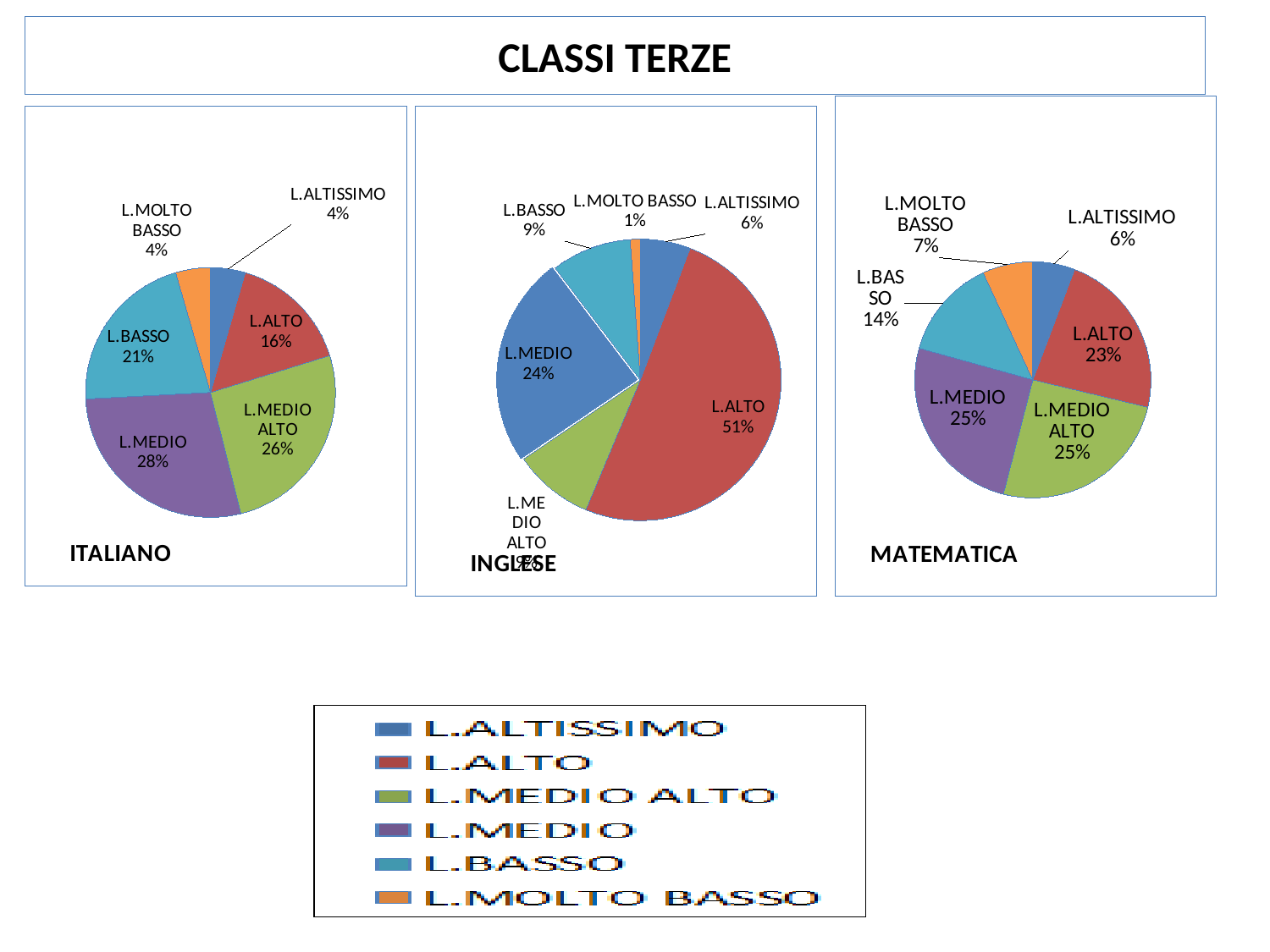
In the MATEMATICA pie chart, what percentage is L.MOLTO BASSO? 7% How many entries does the legend list? 6 In the INGLESE pie chart, which level has the largest share? L.ALTO In the ITALIANO pie chart, what is the difference between L.MEDIO ALTO and L.ALTO? 10% In the ITALIANO pie chart, which level has the largest share? L.MEDIO In the MATEMATICA pie chart, what percentage is L.BASSO? 14% What kind of chart is used for ITALIANO, INGLESE and MATEMATICA? Pie chart In the INGLESE pie chart, which level has the smallest share? L.MOLTO BASSO In the MATEMATICA pie chart, which is larger, L.ALTO or L.BASSO? L.ALTO In the INGLESE pie chart, what percentage is L.ALTO? 51% What is the title of the slide? CLASSI TERZE In the ITALIANO pie chart, what percentage is L.MEDIO? 28%